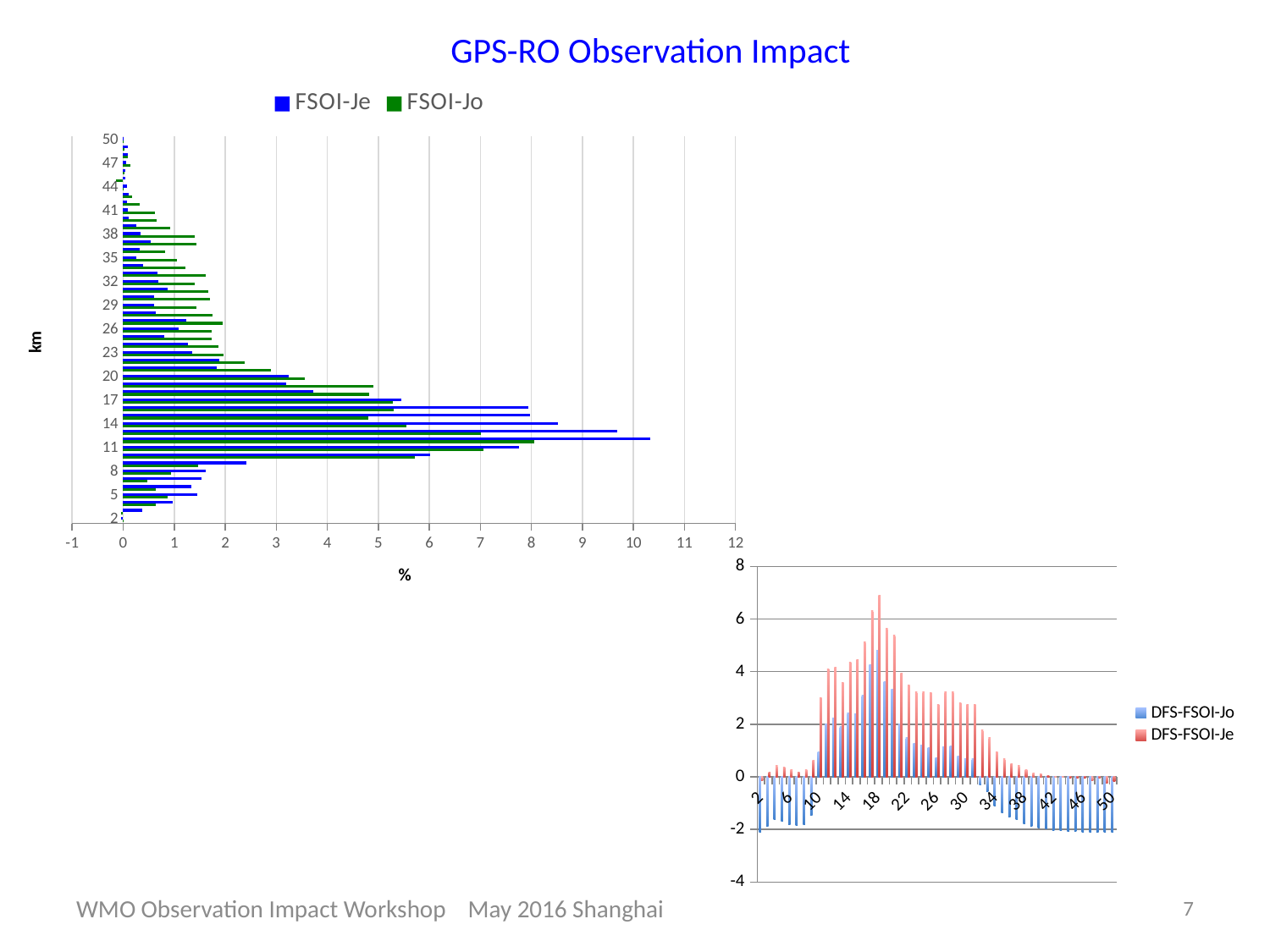
In the top-left chart, what is the label of the horizontal axis? % What are the two series named in the legend of the bottom-right chart? DFS-FSOI-Jo and DFS-FSOI-Je In the top-left chart, which series has the larger value at 26 km, FSOI-Je or FSOI-Jo? FSOI-Jo In the top-left chart, is the FSOI-Jo value at 38 km greater or less than 1? greater In the bottom-right chart, which series reaches the highest peak, DFS-FSOI-Jo or DFS-FSOI-Je? DFS-FSOI-Je In the top-left chart, is the FSOI-Je value at 20 km greater or less than 2? greater What kind of chart is the top-left chart with the FSOI-Je and FSOI-Jo series? bar chart In the bottom-right chart, is the DFS-FSOI-Je value at 18 greater or less than 6? greater In the top-left chart, which series has the larger value at 14 km, FSOI-Je or FSOI-Jo? FSOI-Je How many series does the legend of the top-left chart list? 2 In the top-left chart, do the FSOI-Je values rise or fall as km increases from 20 to 50? fall